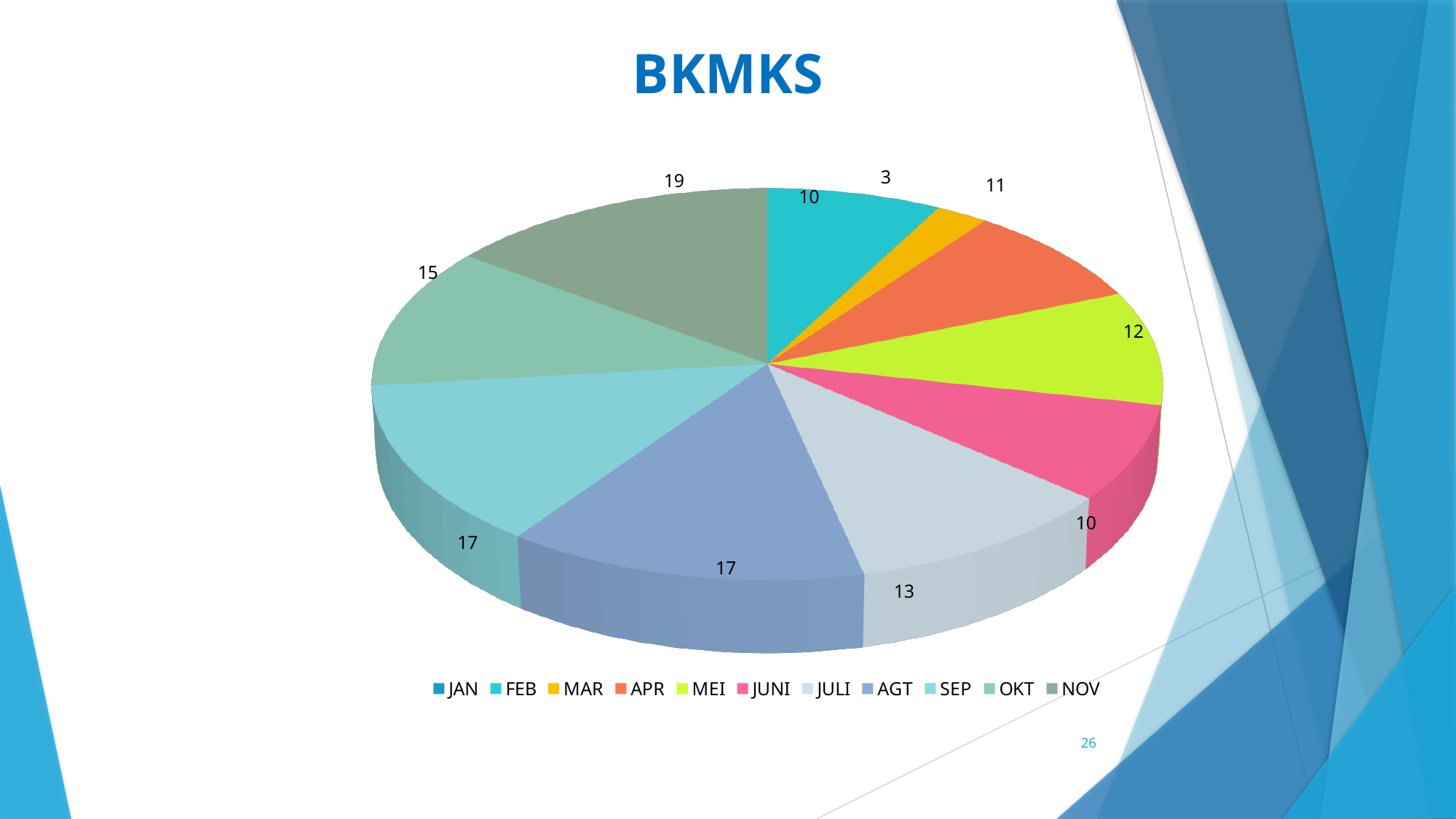
What is the difference between the values for NOV and MAR? 16 What is the value for OKT? 15 What is the value for JULI? 13 Which category has the largest slice? NOV What is the title of the chart? BKMKS Which category has the smallest slice? MAR How many categories does the legend list? 11 What is the difference between the values for AGT and JULI? 4 What is the value for NOV? 19 Which is larger, the value for MEI or the value for APR? MEI What is the value for MAR? 3 What kind of chart is shown on the slide? pie chart